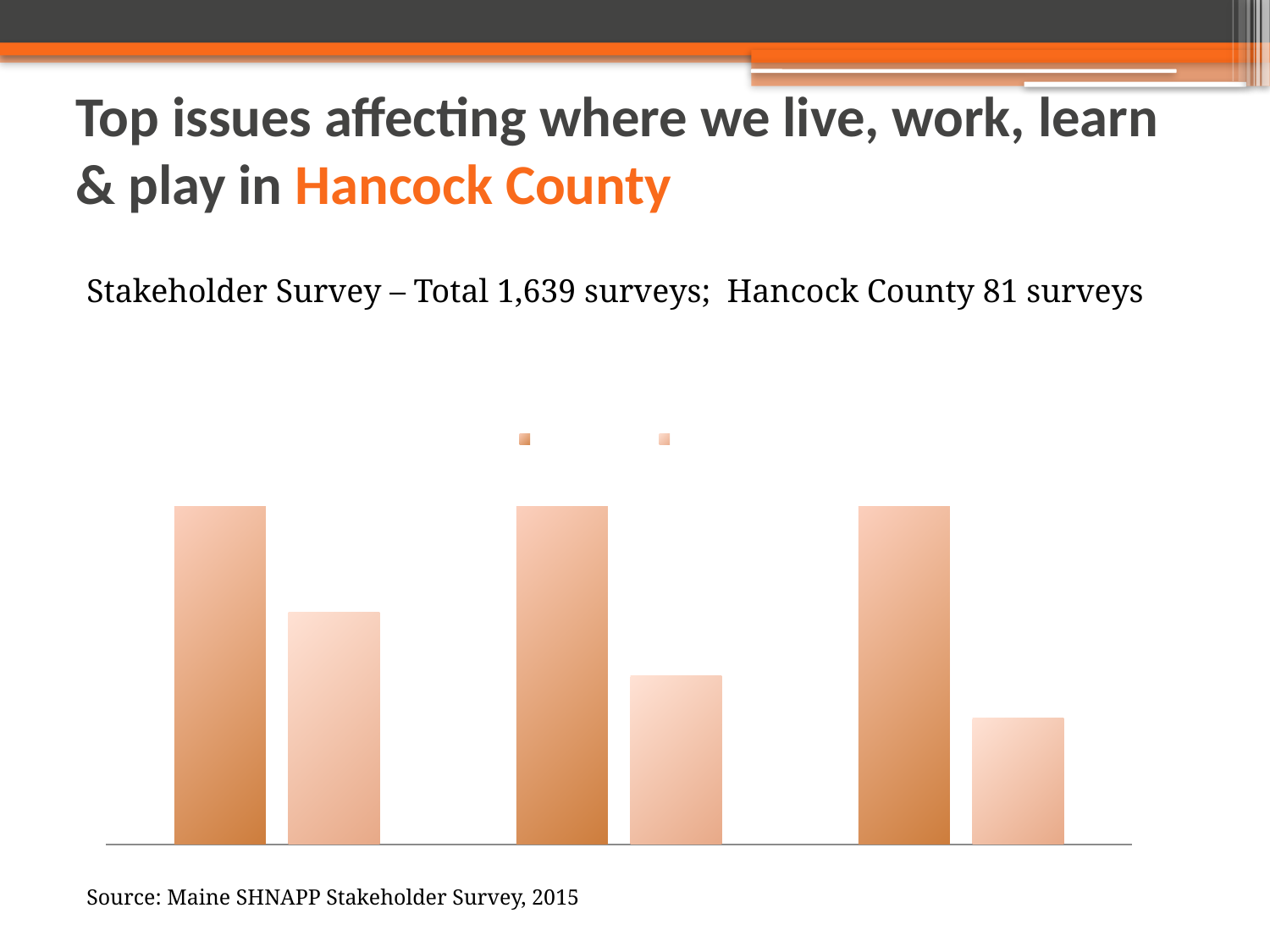
How many groups of bars does the chart show? 3 In the leftmost group of bars, is the darker bar or the lighter bar taller? the darker bar In the rightmost group of bars, is the darker bar or the lighter bar taller? the darker bar Which group of bars has the tallest lighter-coloured bar: the left, middle or right group? the left group Which group of bars has the shortest lighter-coloured bar: the left, middle or right group? the right group What kind of chart is shown on the slide? bar chart How many series does the chart's legend list? 2 Do the lighter-coloured bars rise or fall from left to right across the chart? fall